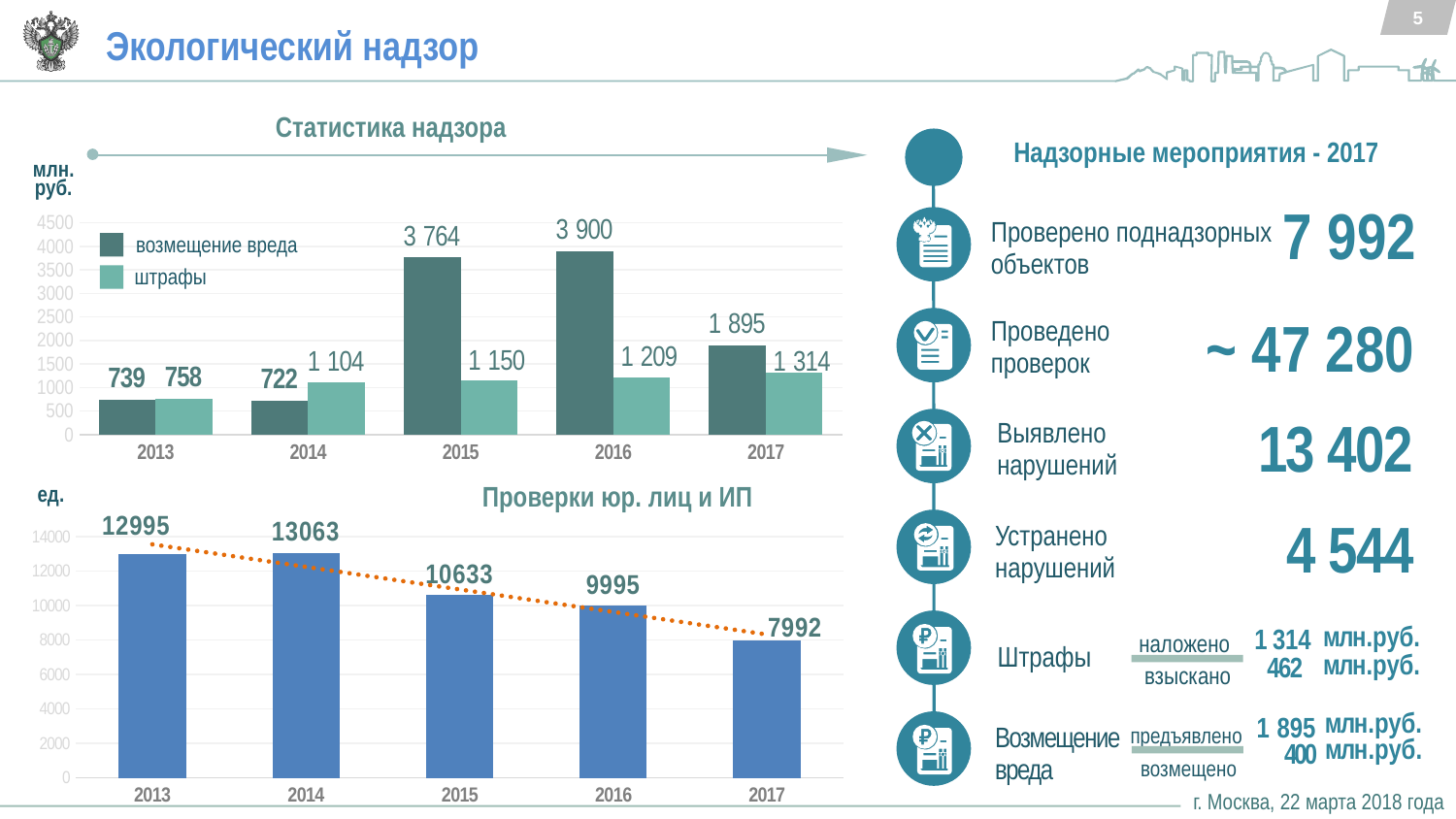
In the chart "Проверки юр. лиц и ИП", which year has the highest value? 2014 In the chart "Статистика надзора", how many series does the legend list? 2 In the chart "Статистика надзора", which year has the highest value for возмещение вреда? 2016 In the chart "Статистика надзора", what is the value for возмещение вреда in 2016? 3 900 In the chart "Статистика надзора", what is the value for штрафы in 2017? 1 314 In the chart "Проверки юр. лиц и ИП", do the values generally rise or fall from 2014 to 2017? fall In the chart "Статистика надзора", which year has the lowest value for штрафы? 2013 What kind of chart is "Проверки юр. лиц и ИП"? bar chart In the chart "Проверки юр. лиц и ИП", how many years are shown on the x axis? 5 In the chart "Проверки юр. лиц и ИП", what is the difference between the values for 2013 and 2017? 5003 In the chart "Проверки юр. лиц и ИП", what is the value for 2015? 10633 In the chart "Статистика надзора", what is the difference between возмещение вреда and штрафы in 2015? 2 614